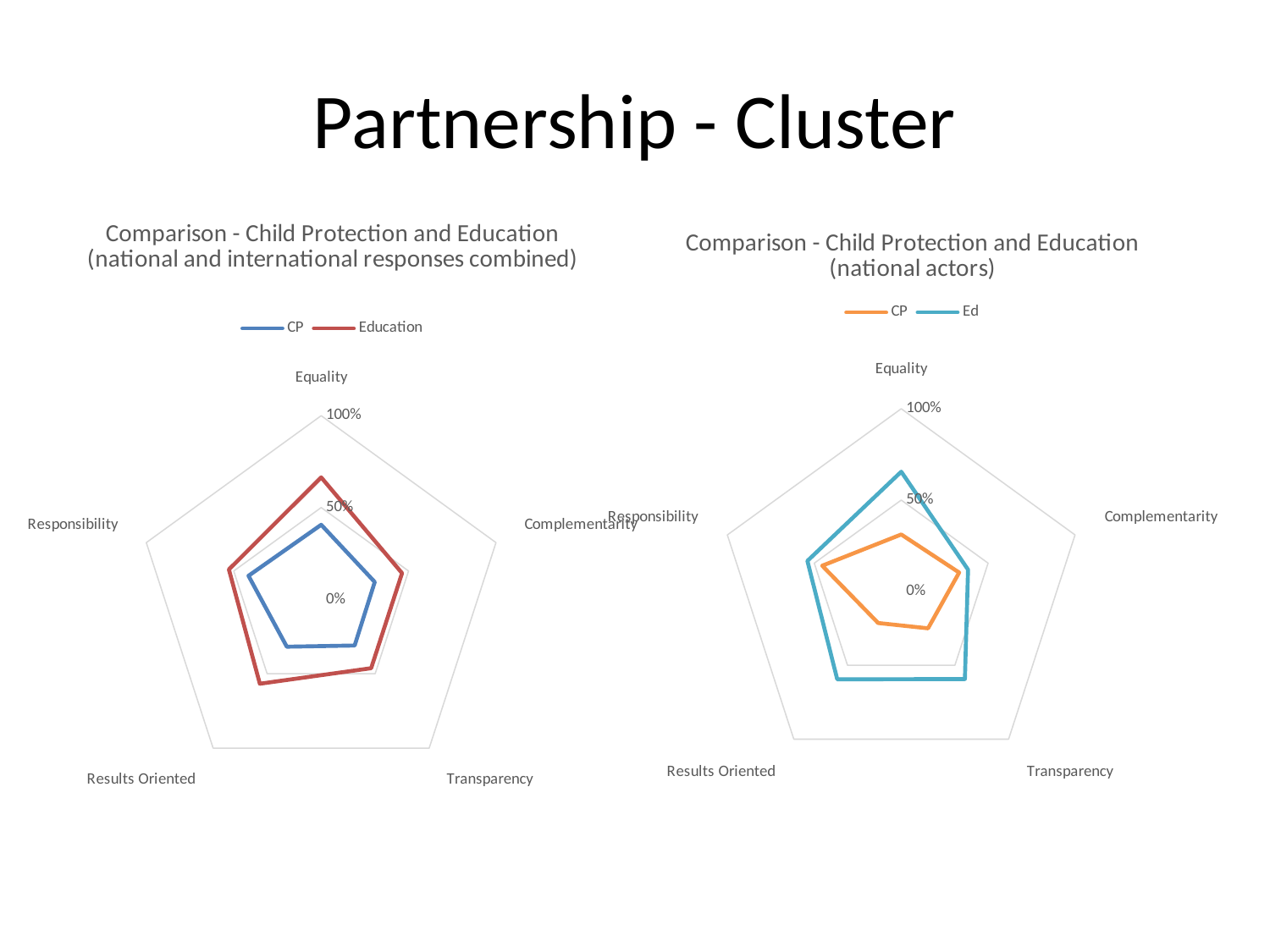
How many series does the legend of the left chart list? 2 What is the highest percentage tick shown on the axis of the right chart? 100% In the left chart, is the Education value for Equality greater or less than 50%? greater What kind of chart is the left chart, 'Comparison - Child Protection and Education (national and international responses combined)'? radar chart In the left chart, is the CP value for Equality greater or less than 50%? less What series names appear in the legend of the right chart, 'Comparison - Child Protection and Education (national actors)'? CP and Ed How many categories (axes) does the left chart have? 5 In the left chart, is the CP value for Transparency greater or less than 50%? less In the left chart, which series has the larger value for Equality, CP or Education? Education In the right chart, which series has the larger value for Results Oriented, CP or Ed? Ed